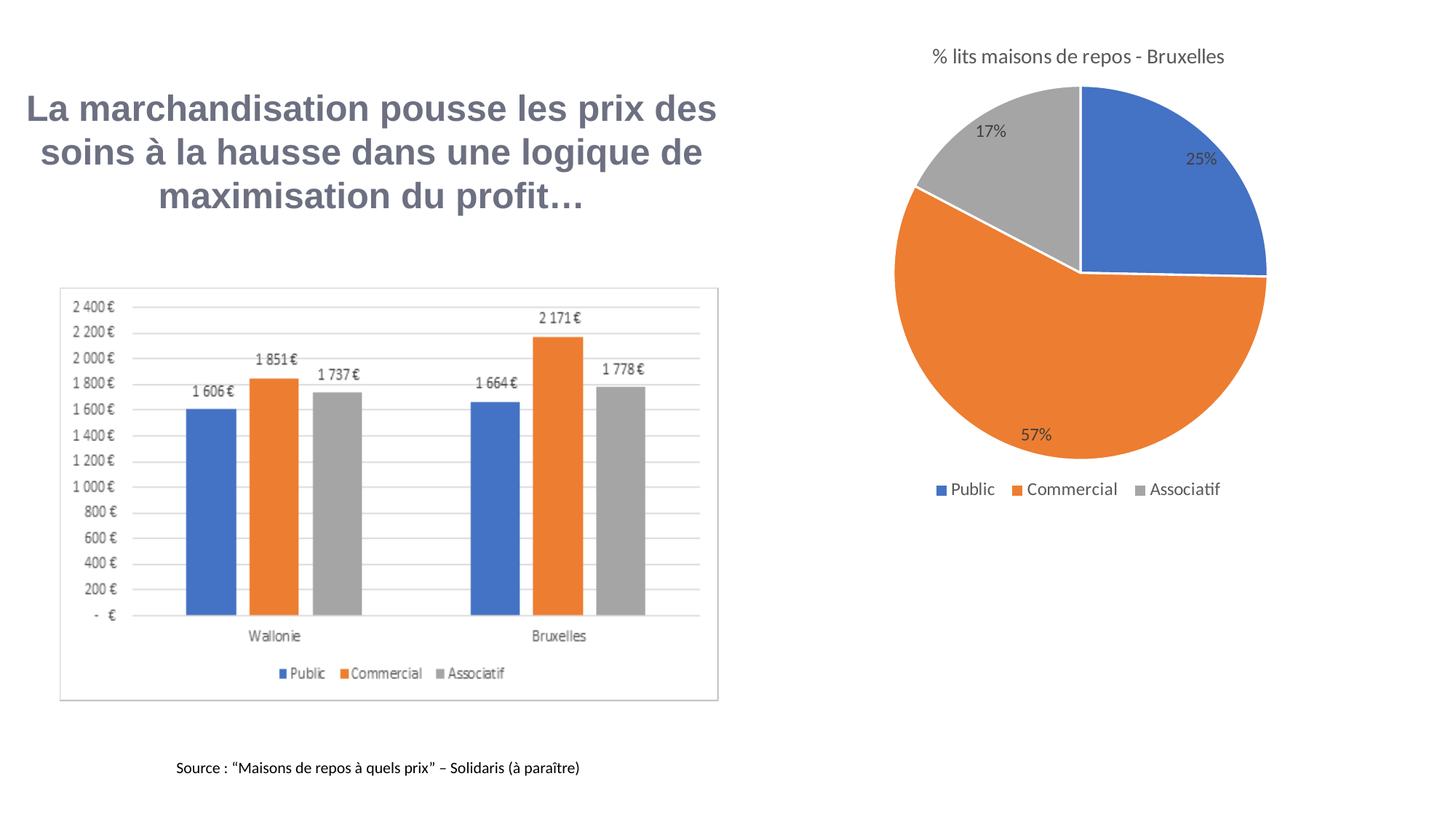
In the bar chart on the left, what is the value for Associatif in Bruxelles? 1 778 € In the bar chart on the left, which is larger: Associatif in Wallonie or Associatif in Bruxelles? Associatif in Bruxelles In the pie chart '% lits maisons de repos - Bruxelles', which category has the smallest slice? Associatif In the bar chart on the left, what is the value for Commercial in Bruxelles? 2 171 € In the bar chart on the left, what is the value for Public in Wallonie? 1 606 € In the bar chart on the left, how many series does the legend list? 3 In the bar chart on the left, which series has the highest value in Bruxelles? Commercial What kind of chart is the chart on the left? Bar chart In the bar chart on the left, what is the difference between the Commercial and Public values in Bruxelles? 507 € In the pie chart '% lits maisons de repos - Bruxelles', what share does Commercial have? 57% In the pie chart '% lits maisons de repos - Bruxelles', what is the difference between the Public and Associatif shares? 8% In the bar chart on the left, which series has the lowest value in Wallonie? Public